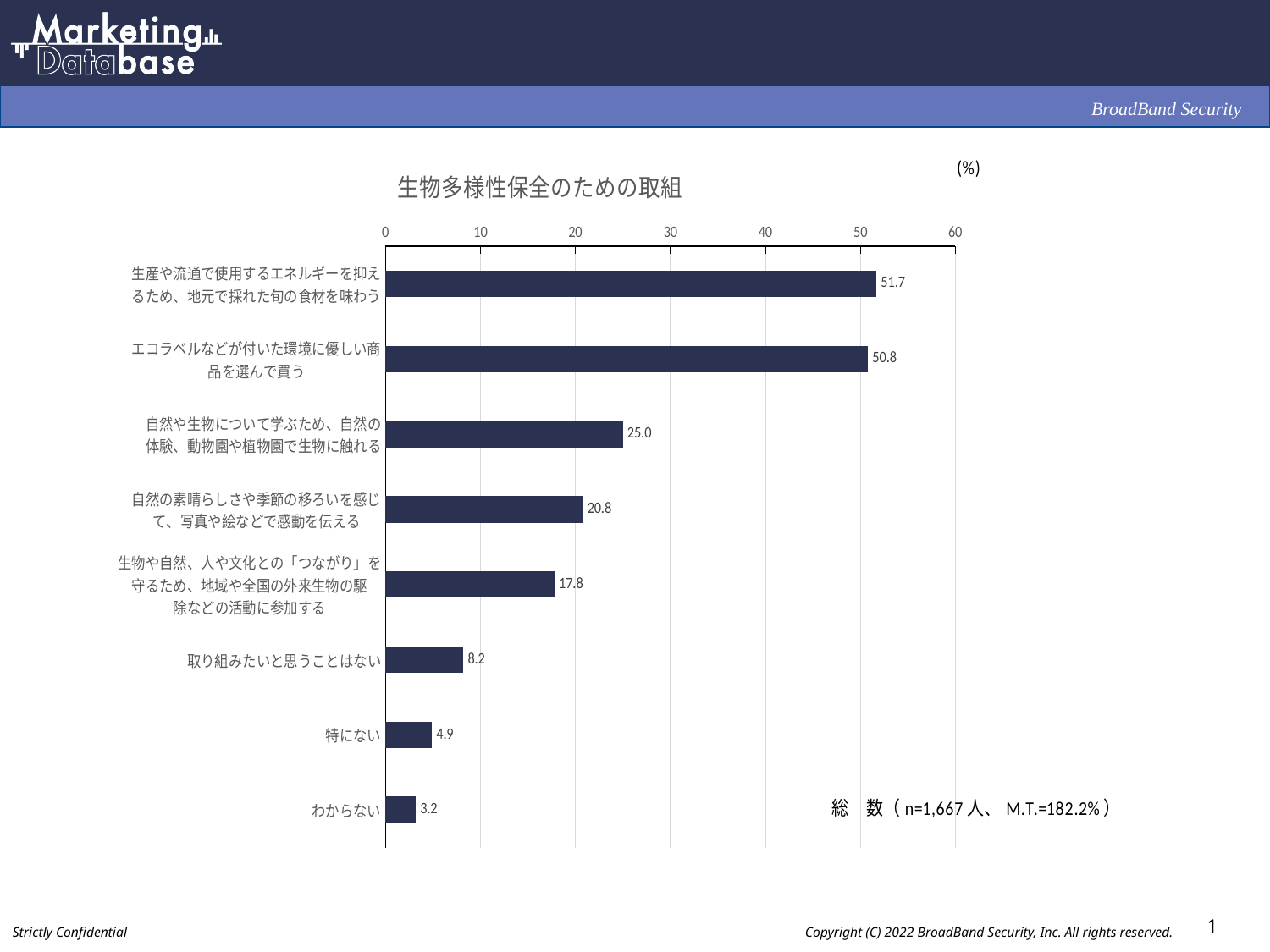
Is the value for 「自然の素晴らしさや季節の移ろいを感じて、写真や絵などで感動を伝える」 greater or less than 30? less Which is larger, the value for 「取り組みたいと思うことはない」 or the value for 「特にない」? 取り組みたいと思うことはない What type of chart is shown on the slide? bar chart What is the value for 「特にない」? 4.9 What is the value for 「自然や生物について学ぶため、自然の体験、動物園や植物園で生物に触れる」? 25.0 What is the difference between the values for 「生産や流通で使用するエネルギーを抑えるため、地元で採れた旬の食材を味わう」 and 「エコラベルなどが付いた環境に優しい商品を選んで買う」? 0.9 How many categories are shown in the chart? 8 What is the value for 「取り組みたいと思うことはない」? 8.2 What is the difference between the values for 「自然の素晴らしさや季節の移ろいを感じて、写真や絵などで感動を伝える」 and 「生物や自然、人や文化との「つながり」を守るため、地域や全国の外来生物の駆除などの活動に参加する」? 3.0 What is the title of the chart? 生物多様性保全のための取組 Which category has the lowest value? わからない Which category has the highest value? 生産や流通で使用するエネルギーを抑えるため、地元で採れた旬の食材を味わう